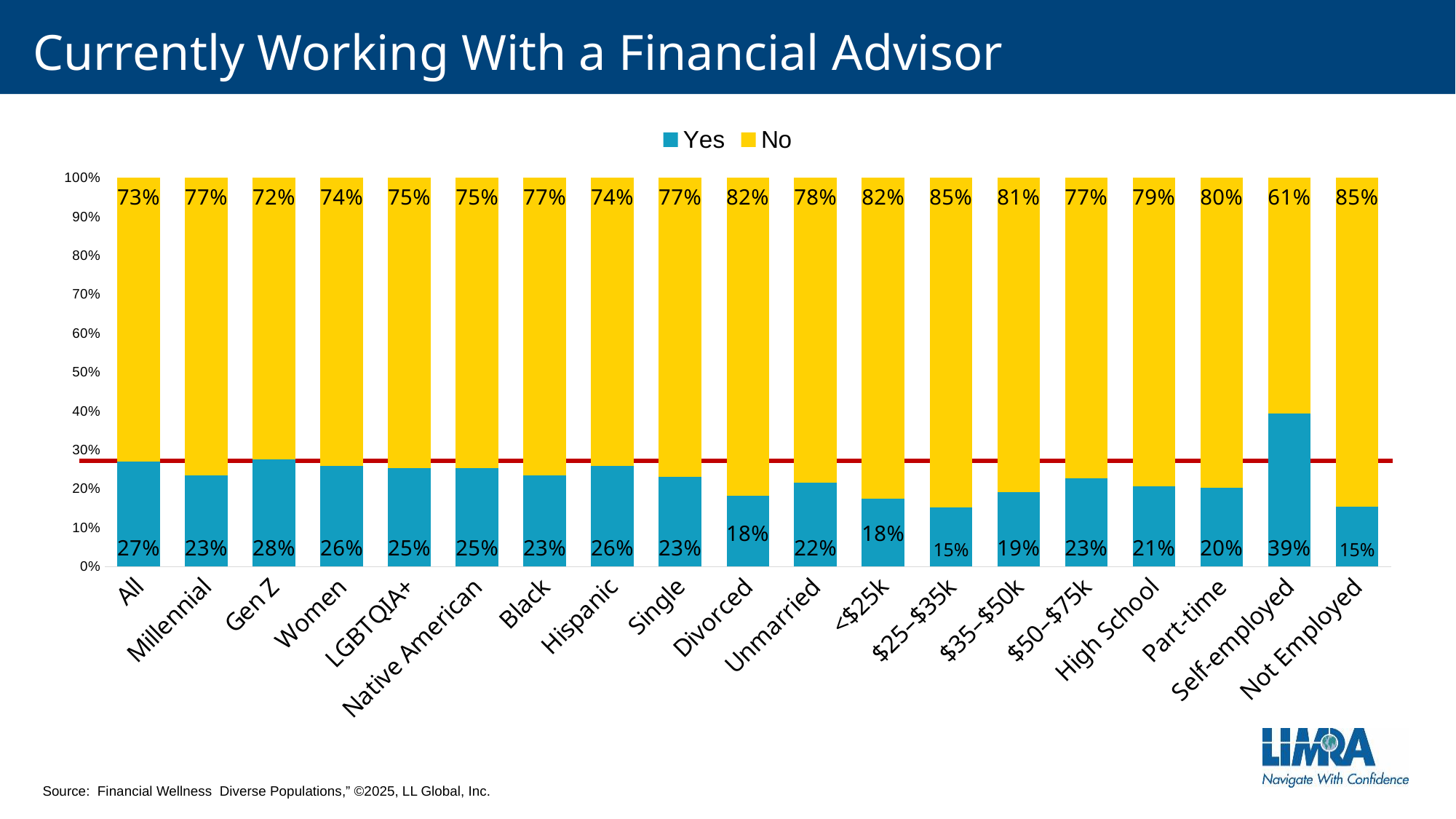
What is the total of the stacked bar for Women? 100% Which category has the lowest No value? Self-employed What is the difference between the Yes values for Self-employed and Not Employed? 24% What is the Yes value for Gen Z? 28% What is the Yes value for Self-employed? 39% What kind of chart is shown? Stacked bar chart How many series does the legend list? 2 How many categories are shown on the x axis? 19 What is the No value for Divorced? 82% Which has a larger Yes value, Gen Z or Divorced? Gen Z What is the No value for All? 73% Which category has the highest Yes value? Self-employed